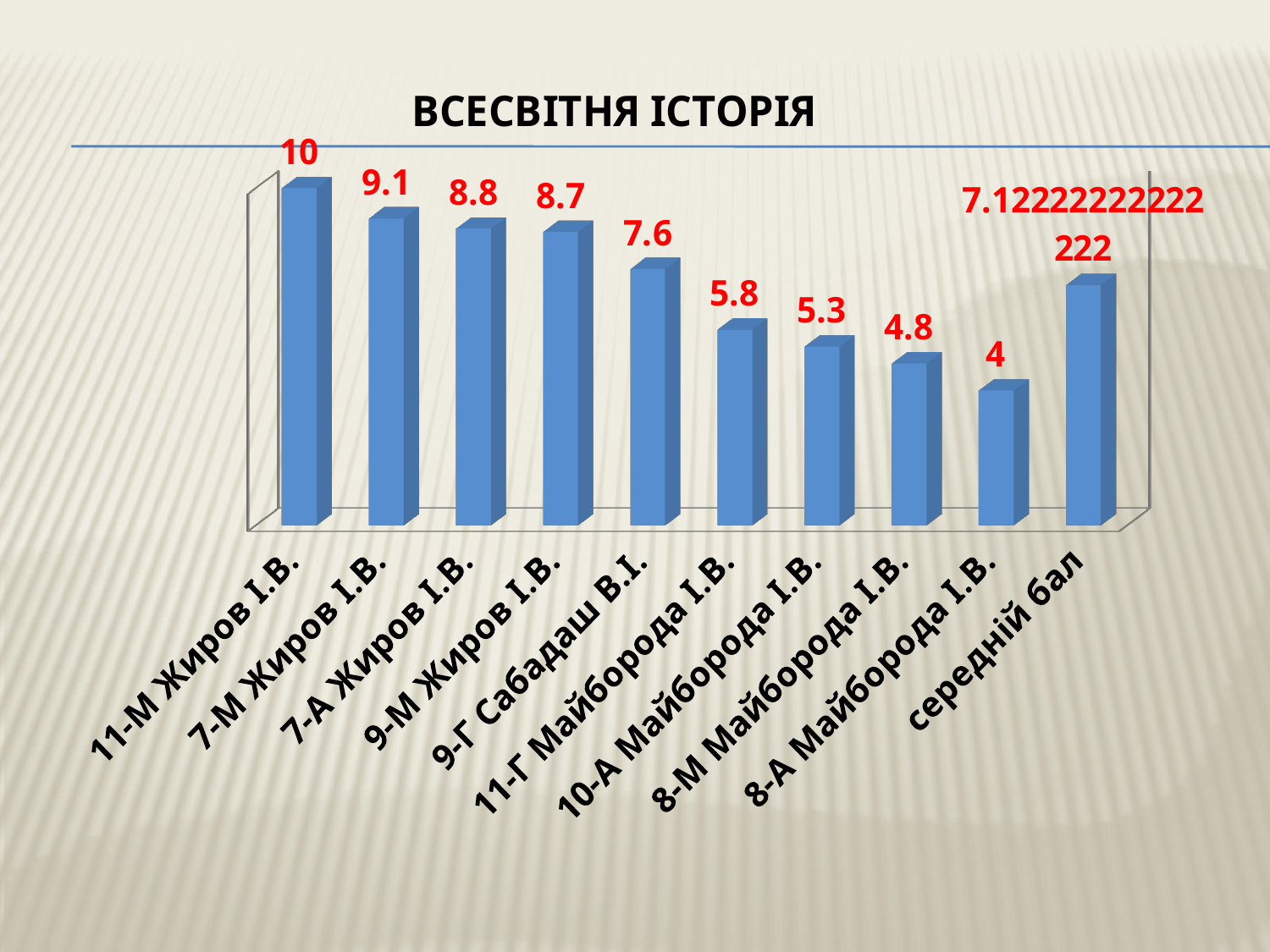
What is the difference between the values for 11-М Жиров І.В. and 8-А Майборода І.В.? 6 What is the value for 10-А Майборода І.В.? 5.3 What is the value for 9-Г Сабадаш В.І.? 7.6 Which category has the highest value? 11-М Жиров І.В. Which category has the lowest value? 8-А Майборода І.В. How many categories are shown on the x axis? 10 What is the value for 8-А Майборода І.В.? 4 Which is larger, the value for 7-М Жиров І.В. or the value for 11-Г Майборода І.В.? 7-М Жиров І.В. What kind of chart is shown on the slide? bar chart What is the title of the chart? ВСЕСВІТНЯ ІСТОРІЯ What is the difference between the values for 7-А Жиров І.В. and 9-М Жиров І.В.? 0.1 What is the value for 11-М Жиров І.В.? 10